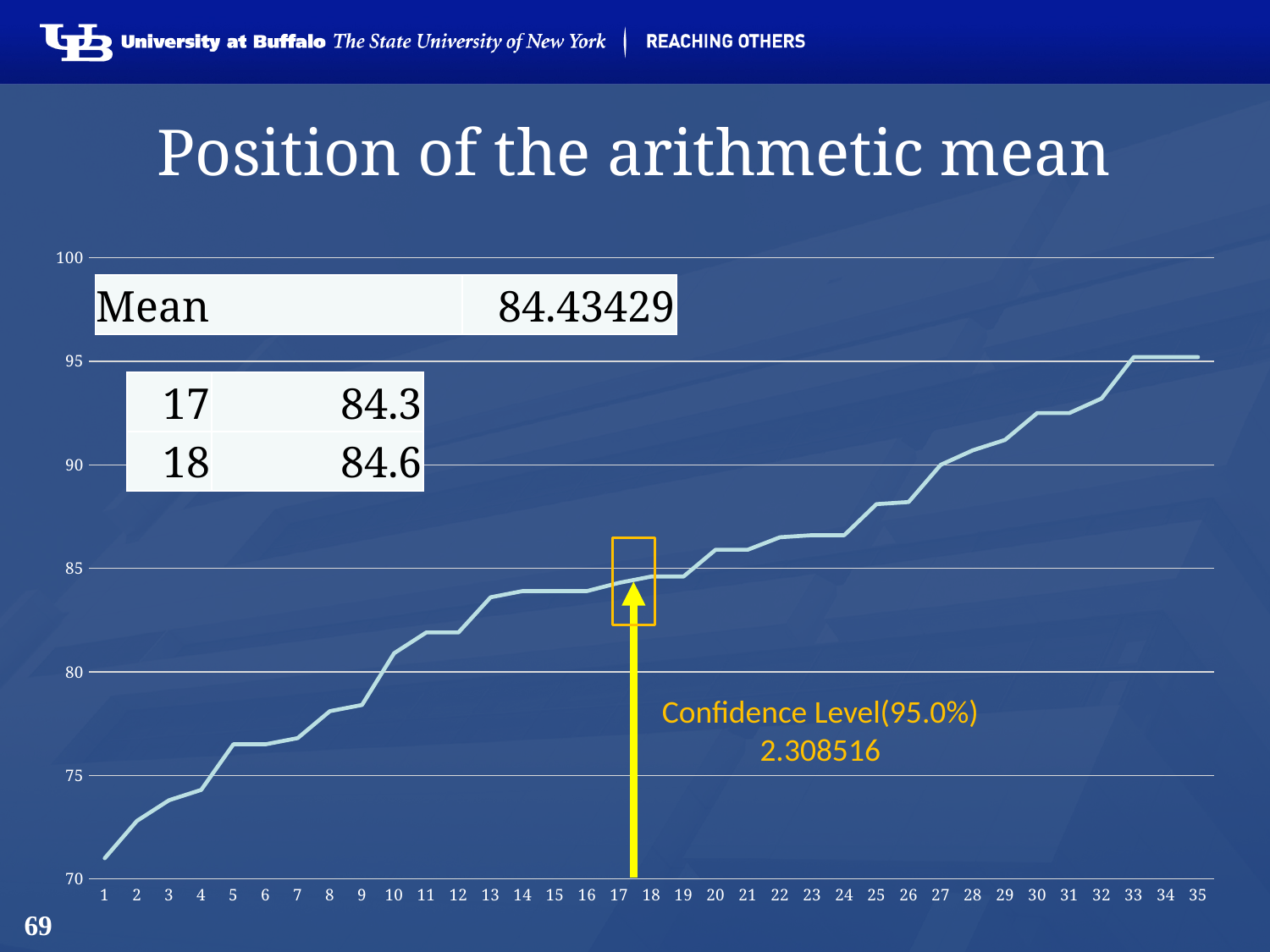
What is the value for position 18 shown in the table on the chart? 84.6 Is the value for position 5 greater or less than 80? less What mean value is printed on the chart? 84.43429 Is the value for position 27 greater or less than 85? greater Do the values rise or fall as the x axis goes from 1 to 35? rise What kind of chart is shown on the slide? line chart What is the value for position 17 shown in the table on the chart? 84.3 Is the value for position 1 greater or less than 75? less How many points are plotted along the x axis? 35 Which position has the lowest value on the chart? 1 Which has the larger value, position 30 or position 10? 30 What is the difference between the values at positions 18 and 17? 0.3